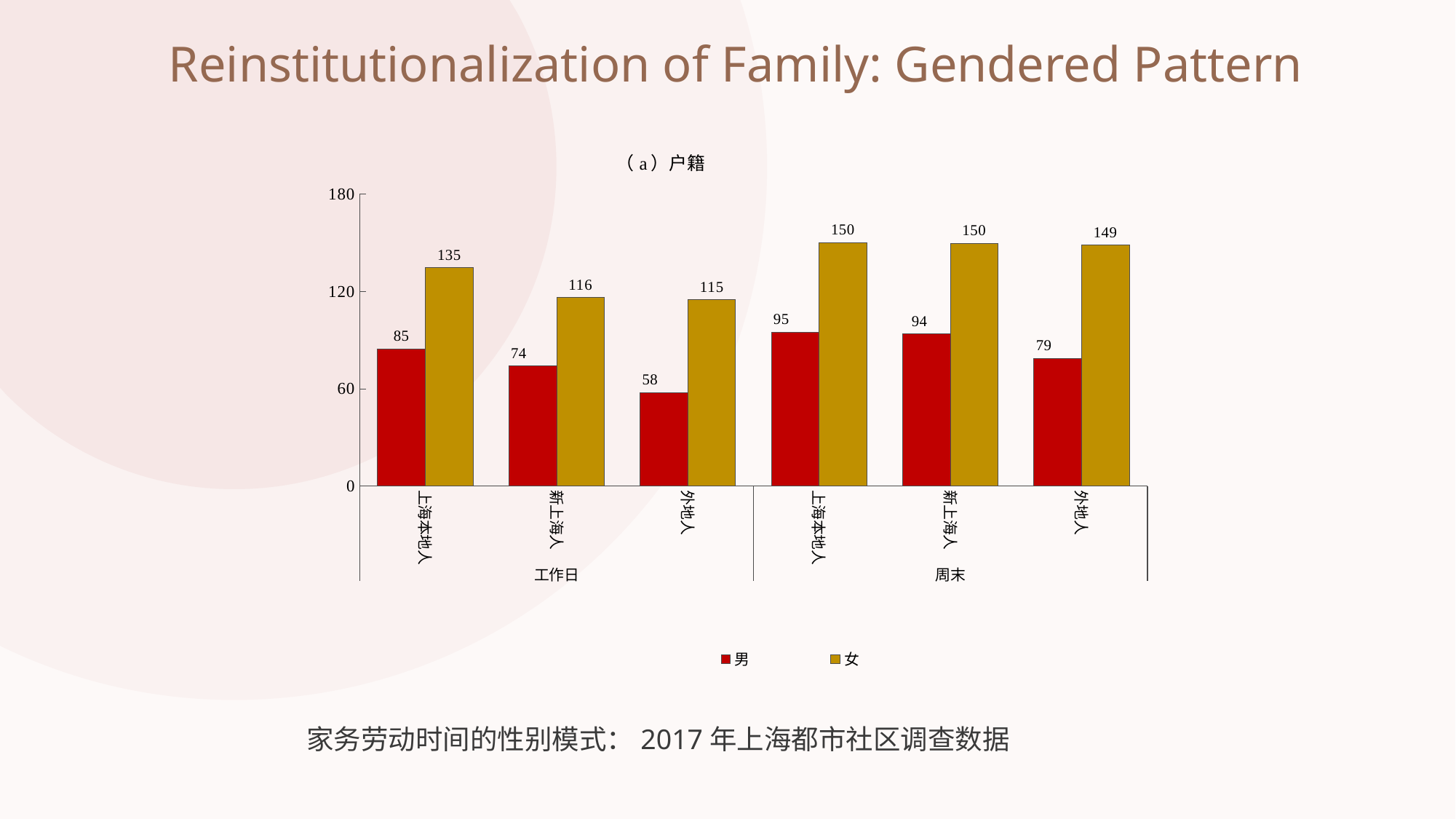
What is the value for 男 for 外地人 on 周末? 79 Which category has the lowest 男 value? 外地人 (工作日) What is the value for 男 for 新上海人 on 工作日? 74 What type of chart is shown on the slide? bar chart What is the title of the chart? （a）户籍 How many series does the legend list? 2 What is the difference between the 男 values for 上海本地人 on 周末 and on 工作日? 10 What is the value for 女 for 上海本地人 on 工作日? 135 Which colour represents the 女 series in the legend? gold What is the difference between the 女 and 男 values for 外地人 on 工作日? 57 Which is larger, the 女 value for 新上海人 on 工作日 or the 女 value for 外地人 on 周末? 外地人 on 周末 How many category groups (bar pairs) are plotted on the x axis? 6